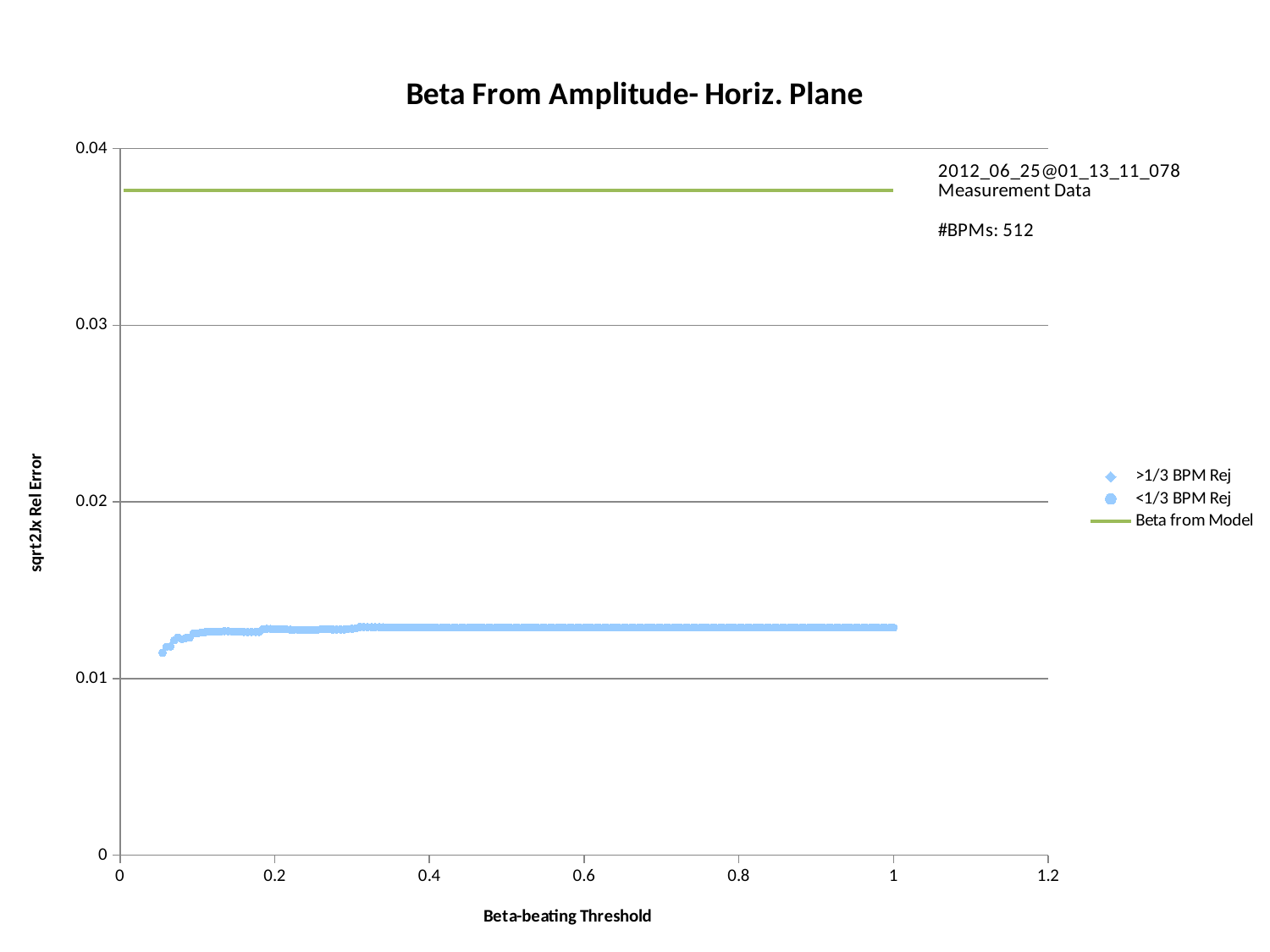
Which is larger, the Beta from Model line or the <1/3 BPM Rej series? Beta from Model Is the value of the Beta from Model line greater or less than 0.04? less Is the value of the <1/3 BPM Rej series at a Beta-beating Threshold of 1 greater or less than 0.02? less Is the value of the <1/3 BPM Rej series at a Beta-beating Threshold of 0.6 greater or less than 0.01? greater What kind of chart is this? scatter chart How many BPMs are stated on the slide? 512 How many series does the legend list? 3 What is the title of the chart? Beta From Amplitude- Horiz. Plane Does the <1/3 BPM Rej series rise or fall between a Beta-beating Threshold of 0.05 and 0.2? rise